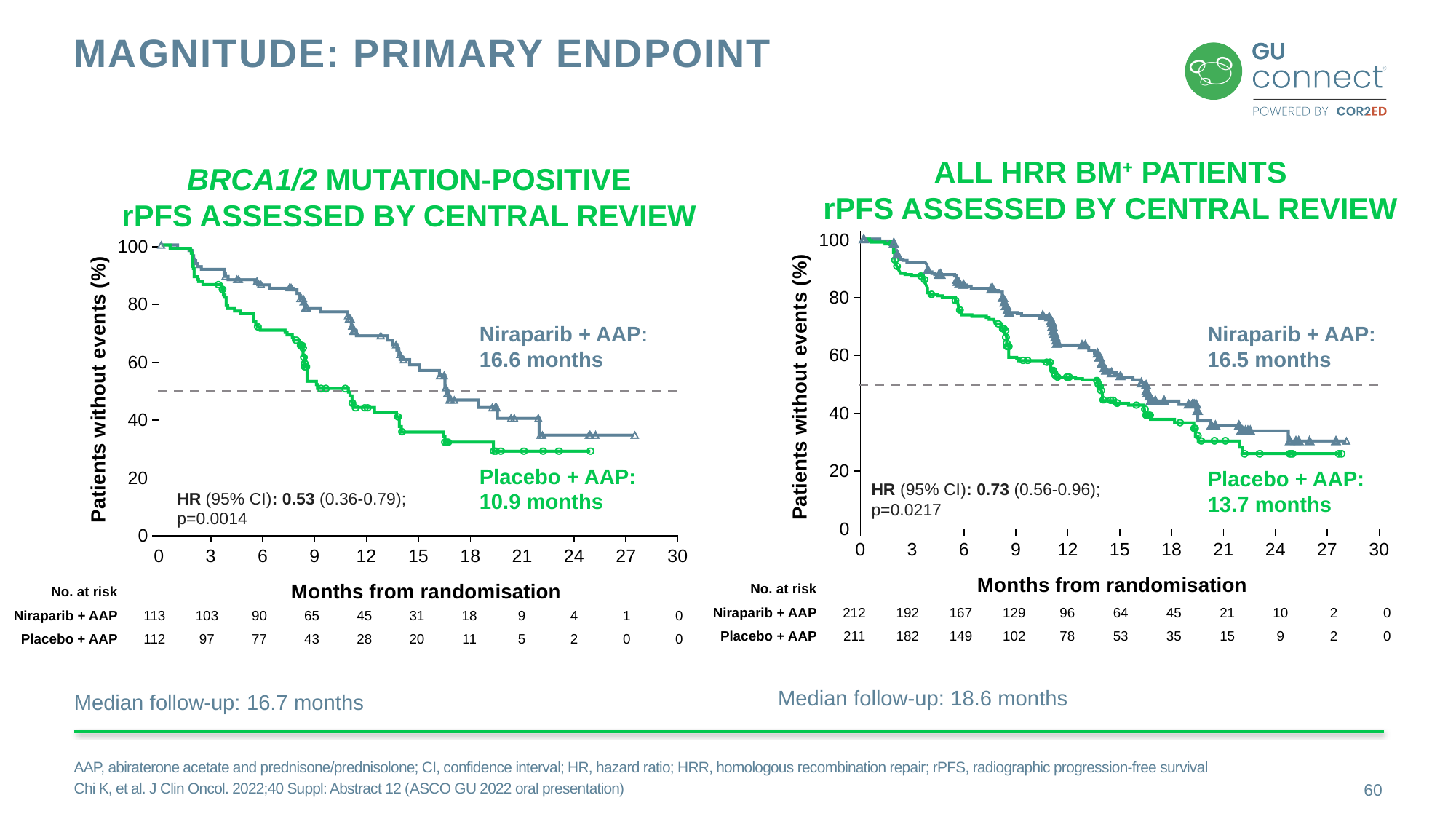
In the All HRR BM+ patients chart, what is the median rPFS for Niraparib + AAP? 16.5 months In the All HRR BM+ patients chart, what is the hazard ratio shown? 0.73 In the BRCA1/2 mutation-positive chart, what is the median rPFS for Niraparib + AAP? 16.6 months In the BRCA1/2 mutation-positive chart, what is the difference in median rPFS between Niraparib + AAP and Placebo + AAP? 5.7 months In the BRCA1/2 mutation-positive chart, is the Placebo + AAP curve at month 12 greater or less than 60? less In the All HRR BM+ patients chart, what is the median rPFS for Placebo + AAP? 13.7 months What kind of chart is the BRCA1/2 mutation-positive chart? Line chart In the All HRR BM+ patients chart, which arm has the longer median rPFS? Niraparib + AAP In the BRCA1/2 mutation-positive chart, what is the hazard ratio shown? 0.53 In the BRCA1/2 mutation-positive chart, how many Niraparib + AAP patients were at risk at month 0? 113 In the All HRR BM+ patients chart, how many Placebo + AAP patients were at risk at month 12? 78 In the BRCA1/2 mutation-positive chart, what is the median rPFS for Placebo + AAP? 10.9 months